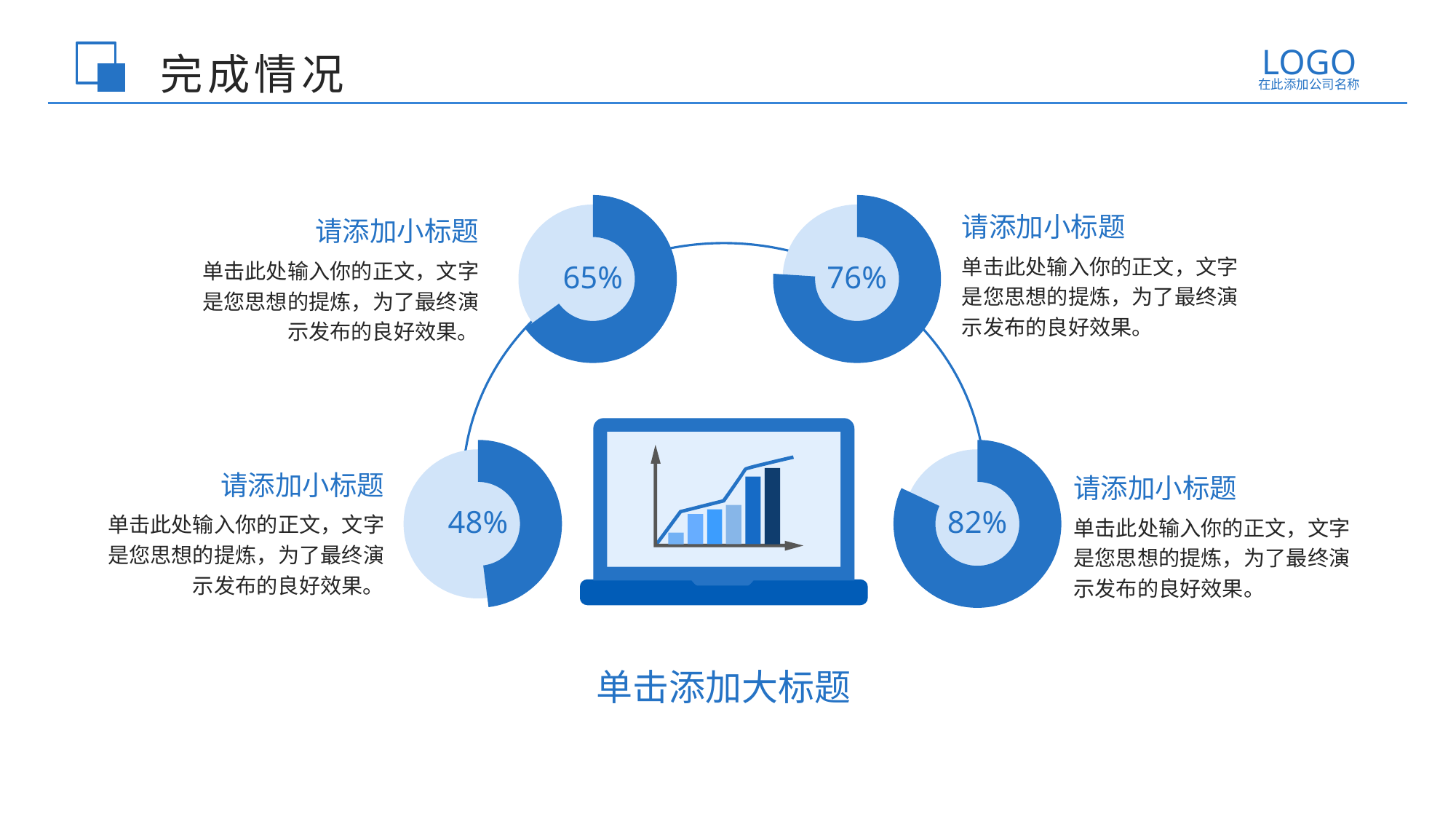
What is the difference between the values in the top-right and top-left donut charts? 11% What value is shown in the top-left donut chart? 65% What value is shown in the bottom-left donut chart? 48% What kind of chart is used to display the four percentages on the slide? Donut chart What value is shown in the bottom-right donut chart? 82% What value is shown in the top-right donut chart? 76% How many donut charts are shown on the slide? 4 Which of the four donut charts shows the highest percentage? The bottom-right one (82%) What is the title of the slide containing the four donut charts? 完成情况 Which is larger, the value in the top-left donut chart or the value in the top-right donut chart? The top-right (76%) Which of the four donut charts shows the lowest percentage? The bottom-left one (48%) What is the difference between the values in the bottom-right and bottom-left donut charts? 34%